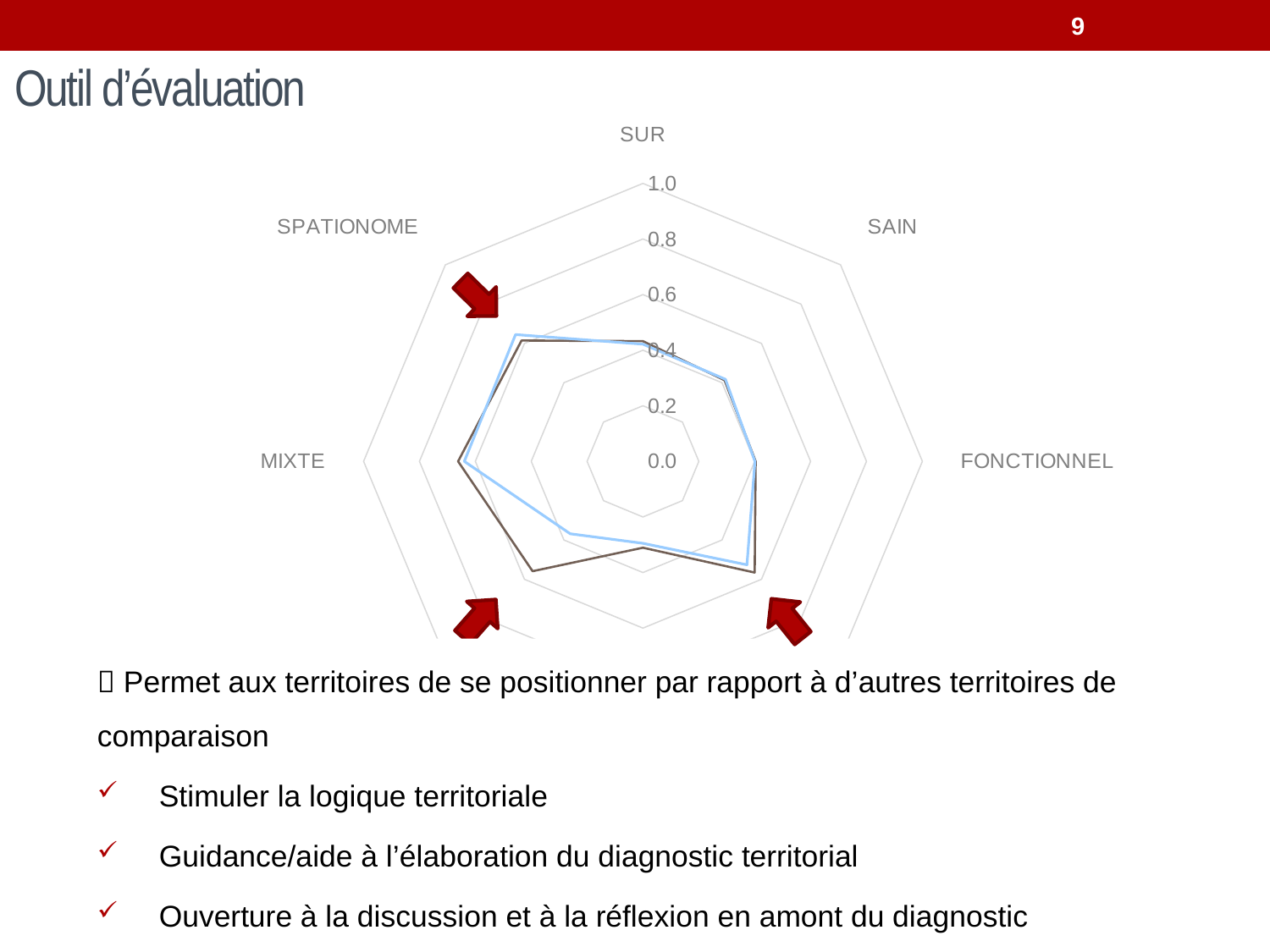
For the blue series, which is larger: the value for MIXTE or the value for SUR? MIXTE Is the value for SPATIONOME on the blue series greater or less than 0.8? less Is the value for SAIN on the blue series greater or less than 0.8? less Is the value for MIXTE on the dark brown series greater or less than 0.6? greater What kind of chart is shown on the slide? radar chart Among the labelled axes SUR, SAIN, FONCTIONNEL, MIXTE and SPATIONOME, which has the highest value for the dark brown series? MIXTE What is the highest value shown on the radar chart's axis scale? 1.0 What is the lowest value shown on the radar chart's axis scale? 0.0 How many data series are plotted on the radar chart? 2 For the dark brown series, which is larger: the value for SPATIONOME or the value for SAIN? SPATIONOME